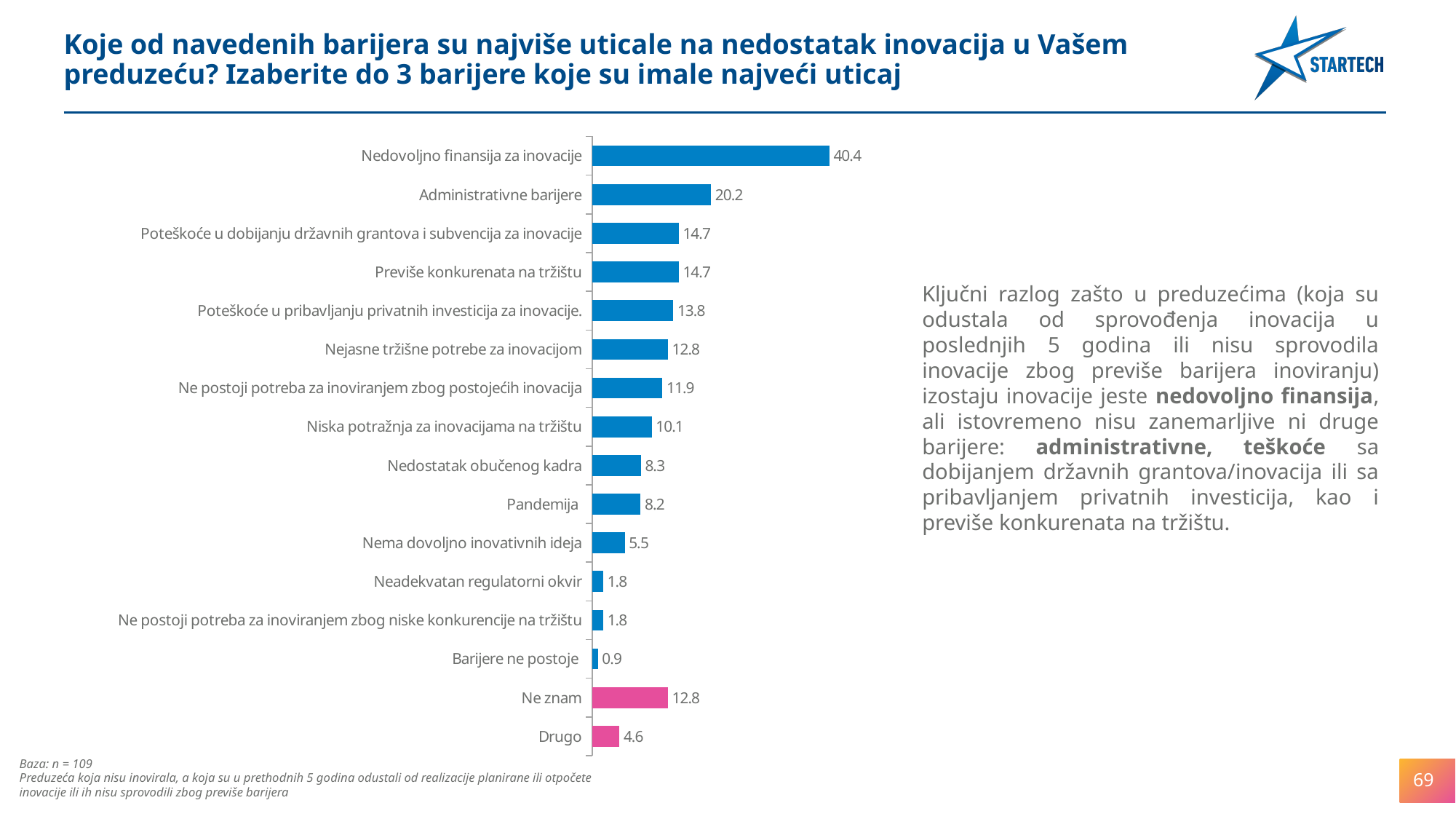
Which category has the lowest value? Barijere ne postoje What is the value for "Pandemija"? 8.2 What is the difference between the values for "Niska potražnja za inovacijama na tržištu" and "Drugo"? 5.5 What kind of chart is shown on the slide? Bar chart What is the value for "Nedovoljno finansija za inovacije"? 40.4 Which two categories are shown with pink bars instead of blue? Ne znam and Drugo What is the value for "Ne znam"? 12.8 Which category has the highest value? Nedovoljno finansija za inovacije How many categories are shown in the chart? 16 What is the value for "Administrativne barijere"? 20.2 Which is larger, the value for "Nedostatak obučenog kadra" or the value for "Nema dovoljno inovativnih ideja"? Nedostatak obučenog kadra What is the difference between the values for "Nedovoljno finansija za inovacije" and "Administrativne barijere"? 20.2